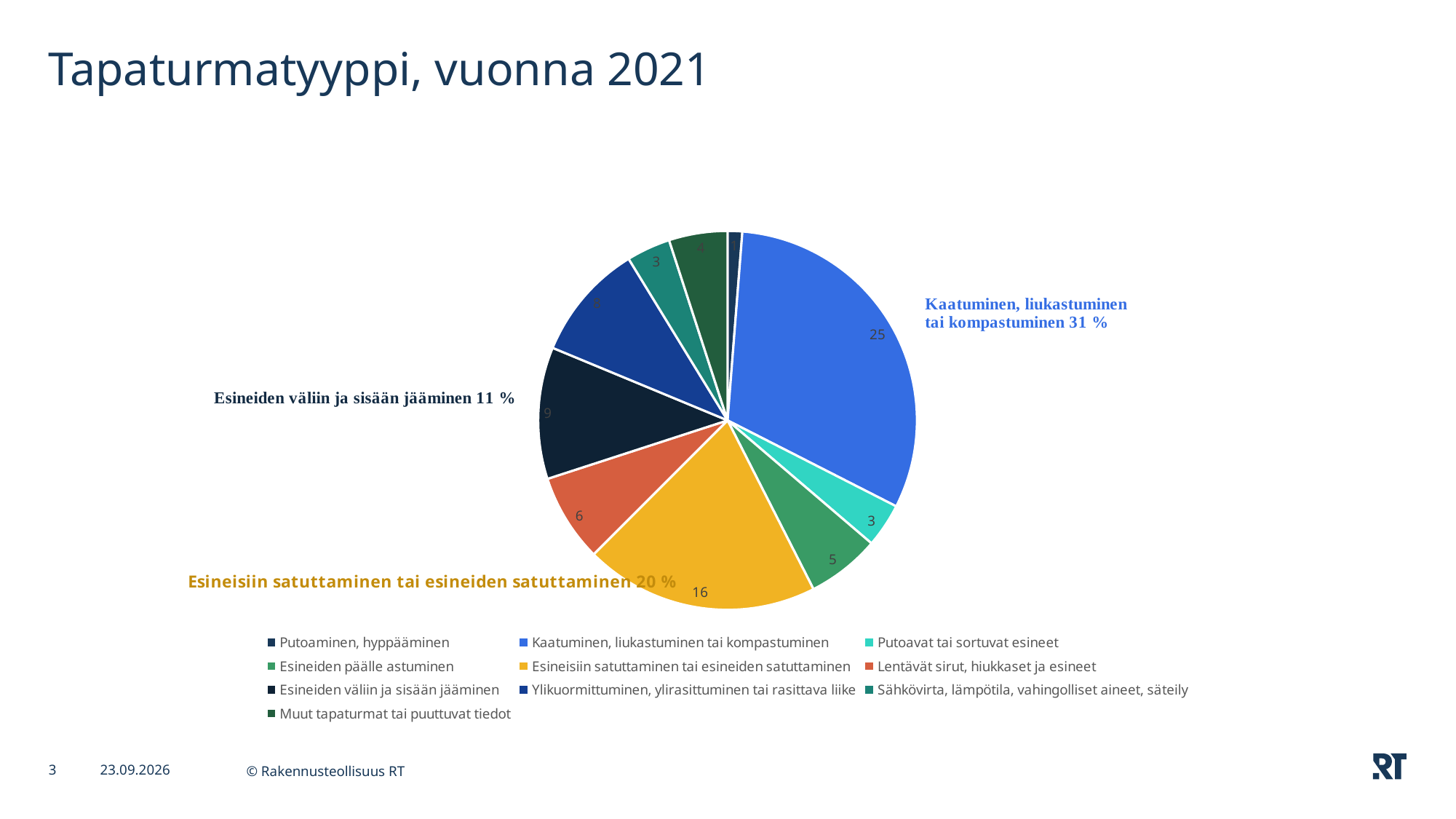
What is the value shown for Esineisiin satuttaminen tai esineiden satuttaminen? 16 What is the difference between the values for Kaatuminen, liukastuminen tai kompastuminen and Esineisiin satuttaminen tai esineiden satuttaminen? 9 What kind of chart is shown on the slide? pie chart What is the value shown for Ylikuormittuminen, ylirasittuminen tai rasittava liike? 8 What is the value shown for Lentävät sirut, hiukkaset ja esineet? 6 What is the value shown for Esineiden väliin ja sisään jääminen? 9 What share of the pie does Esineisiin satuttaminen tai esineiden satuttaminen represent, according to the annotation? 20 % What is the title of the chart? Tapaturmatyyppi, vuonna 2021 What is the value shown for Kaatuminen, liukastuminen tai kompastuminen? 25 How many categories does the legend list? 10 Which category has the largest slice of the pie? Kaatuminen, liukastuminen tai kompastuminen What share of the pie does Kaatuminen, liukastuminen tai kompastuminen represent, according to the annotation? 31 %